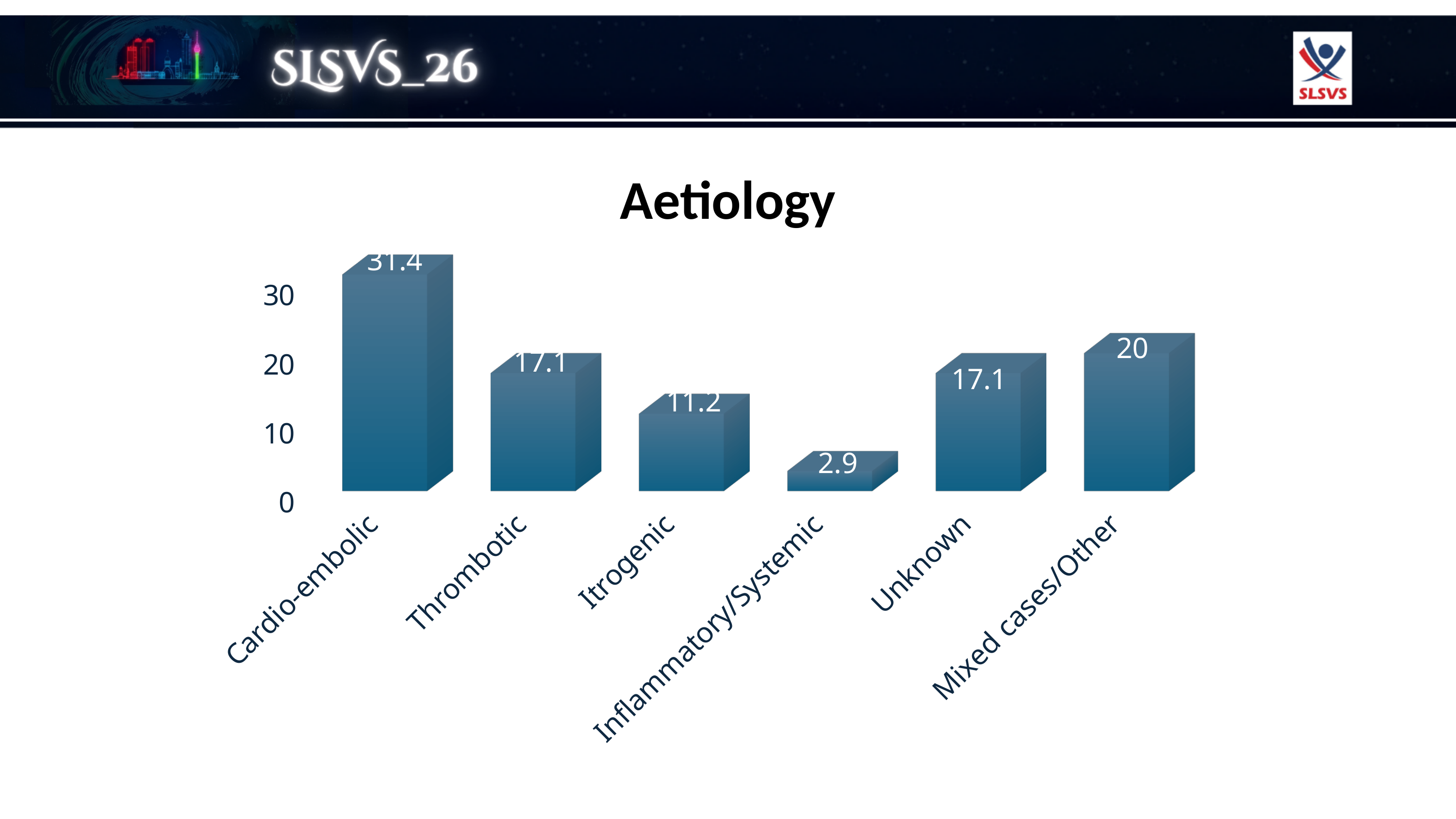
Which category has the lowest value? Inflammatory/Systemic Which is larger, the value for Thrombotic or the value for Itrogenic? Thrombotic Is the value for Unknown greater or less than 10? greater What is the difference between the values for Cardio-embolic and Mixed cases/Other? 11.4 What kind of chart is shown on the slide? bar chart What is the value for Cardio-embolic? 31.4 What is the value for Inflammatory/Systemic? 2.9 How many categories are shown in the chart? 6 Which category has the highest value? Cardio-embolic What is the value for Itrogenic? 11.2 What is the value for Mixed cases/Other? 20 What is the title of the chart? Aetiology